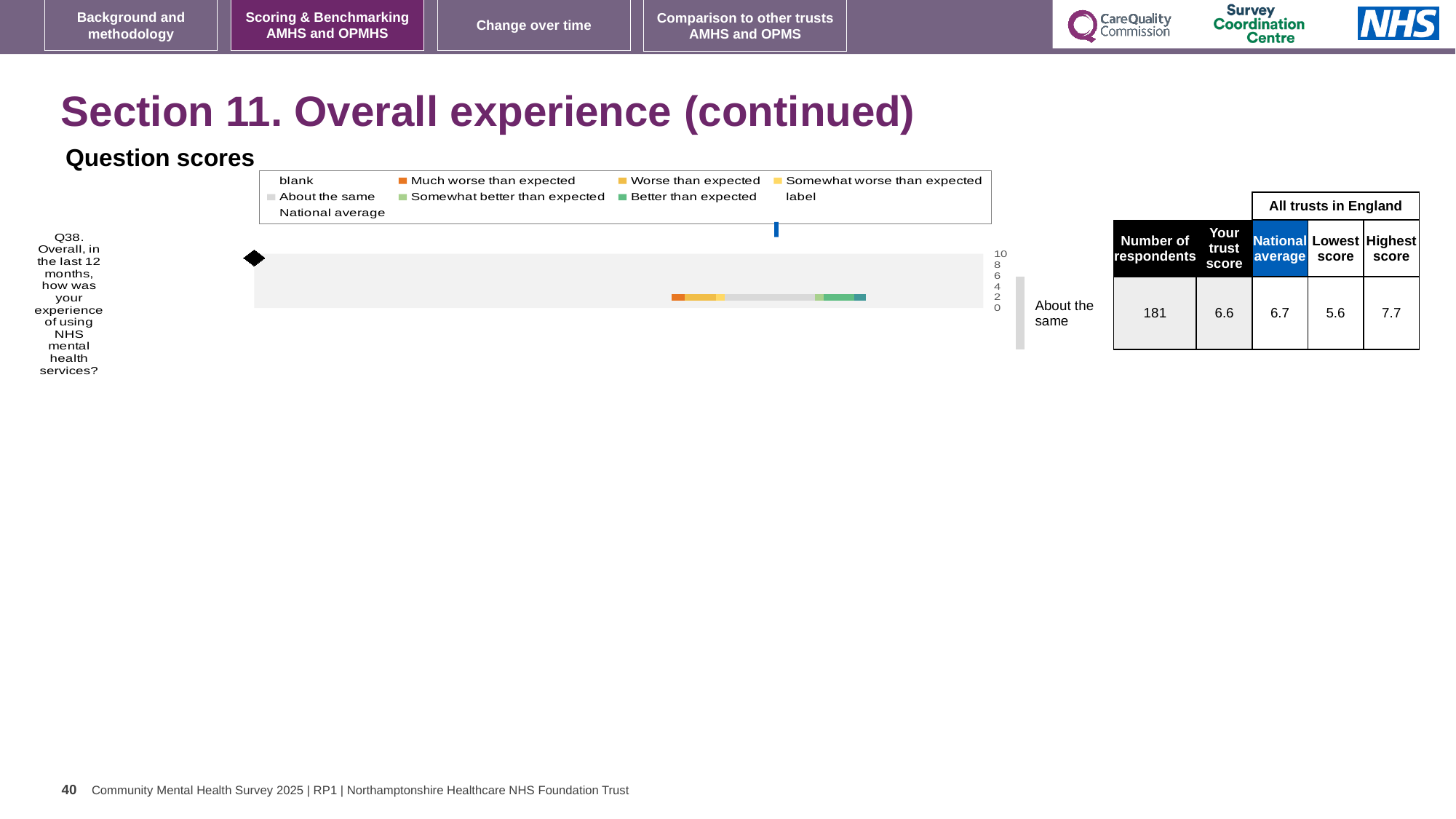
In the table beside the chart, what is the number of respondents for Q38? 181 Which question is plotted in the chart? Q38. Overall, in the last 12 months, how was your experience of using NHS mental health services? How many questions are plotted in the chart? 1 In the table beside the chart, what is the national average for Q38? 6.7 What is the benchmark category shown to the right of the Q38 bar? About the same Which is larger for Q38, the trust score or the national average? national average In the table beside the chart, what is the highest score among all trusts in England for Q38? 7.7 What is the difference between the highest score and the lowest score for Q38 in the table? 2.1 What kind of chart is shown under 'Question scores'? bar chart What colour does the legend use for 'Much worse than expected'? orange In the table beside the chart, what is the lowest score among all trusts in England for Q38? 5.6 In the table beside the chart, what is 'Your trust score' for Q38? 6.6